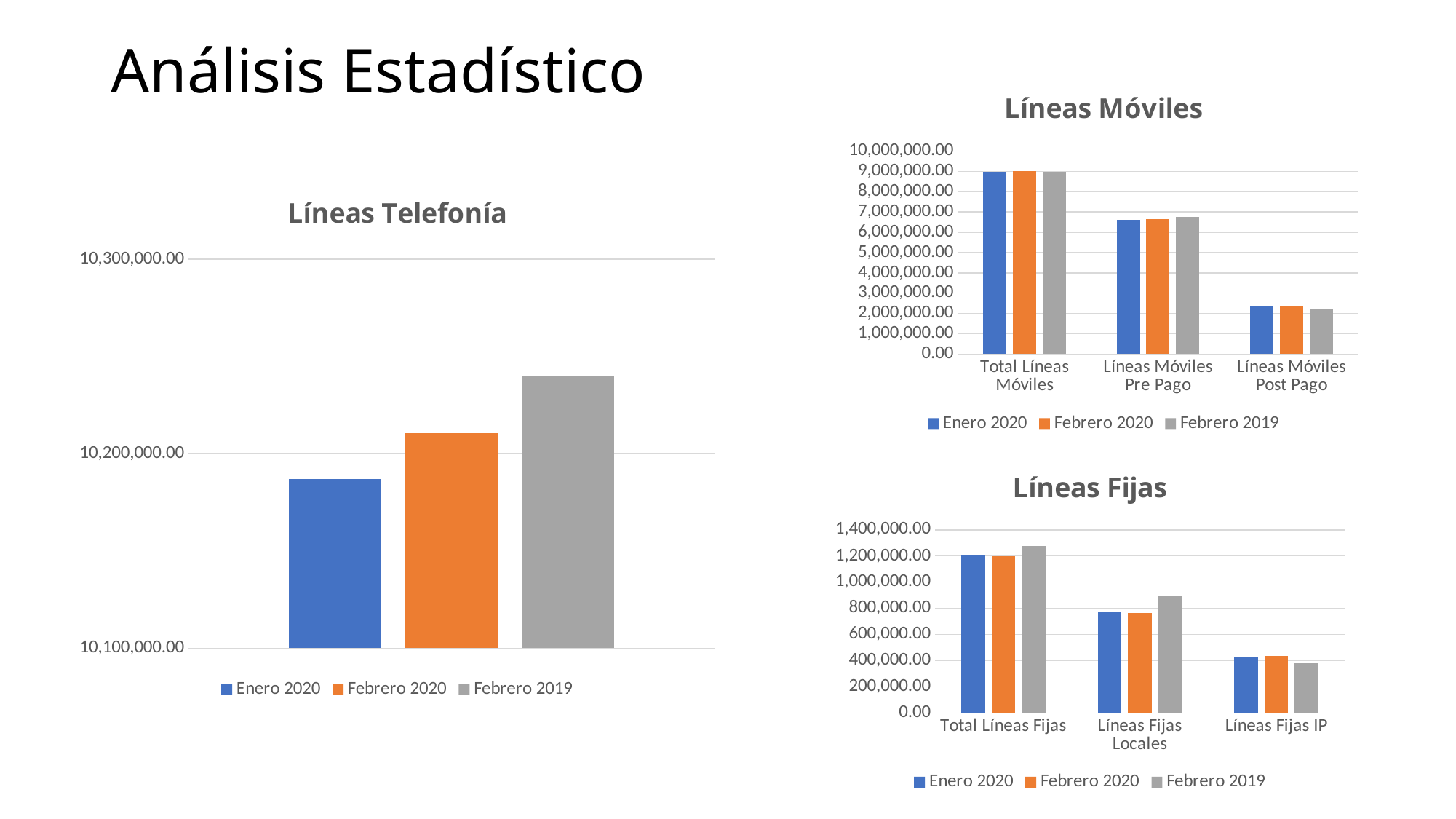
In the "Líneas Móviles" chart, which is larger for Enero 2020: Líneas Móviles Pre Pago or Líneas Móviles Post Pago? Líneas Móviles Pre Pago In the "Líneas Telefonía" chart, is the value for Enero 2020 greater or less than 10,200,000.00? less In the "Líneas Fijas" chart, is the Febrero 2019 value for Líneas Fijas Locales greater or less than 800,000.00? greater In the "Líneas Fijas" chart, which colour represents Febrero 2020? orange How many categories are shown on the x axis of the "Líneas Móviles" chart? 3 What kind of chart is the "Líneas Telefonía" chart? bar chart In the "Líneas Telefonía" chart, which series has the lowest value? Enero 2020 In the "Líneas Telefonía" chart, is the value for Febrero 2020 greater or less than 10,200,000.00? greater In the "Líneas Fijas" chart, which series has the highest value for Total Líneas Fijas? Febrero 2019 How many series does the legend of the "Líneas Móviles" chart list? 3 In the "Líneas Telefonía" chart, which series has the highest value? Febrero 2019